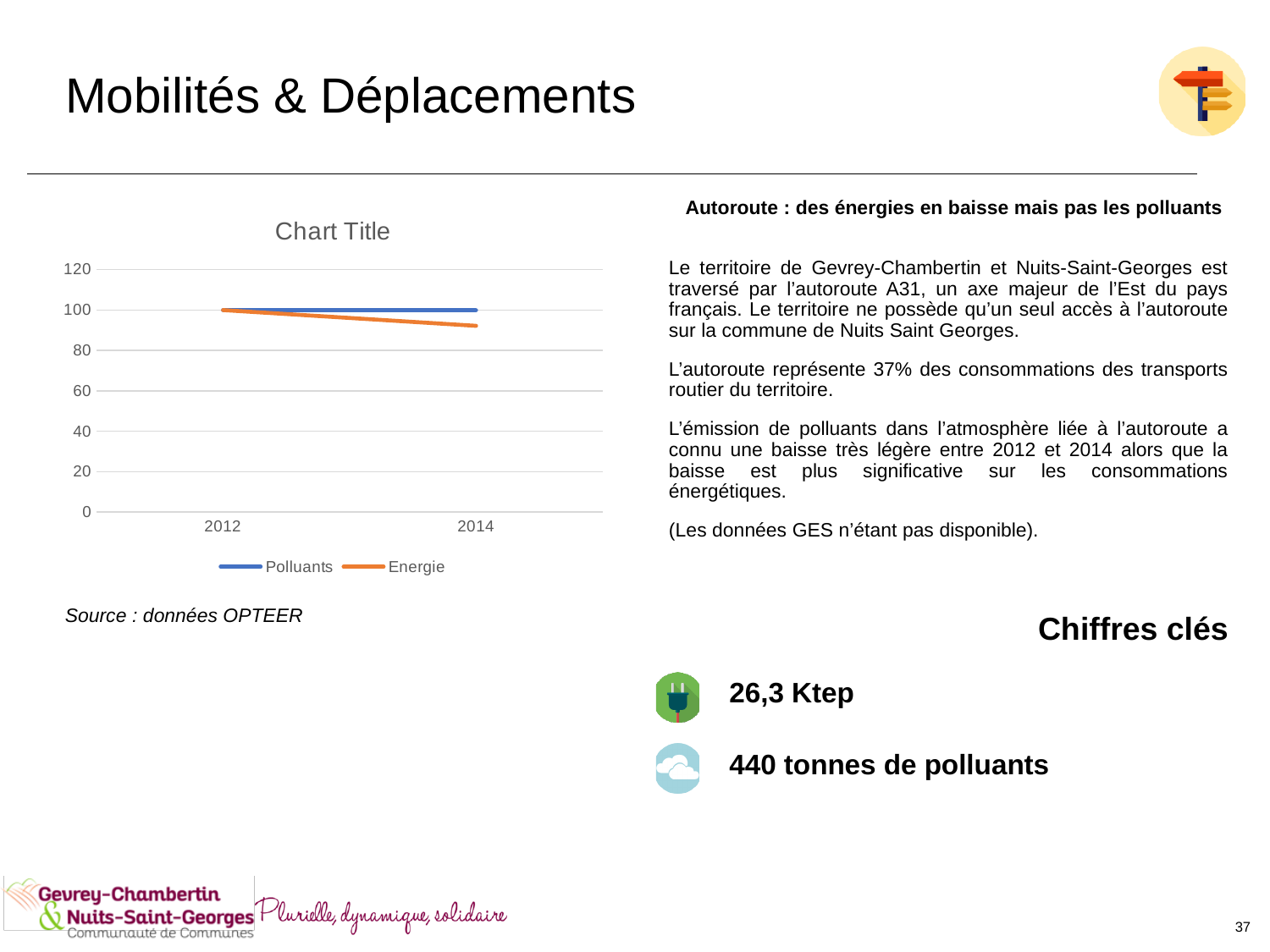
Does the Energie line rise or fall from 2012 to 2014? fall Which two years are shown on the x axis of the chart? 2012 and 2014 In 2014, which series has the higher value, Polluants or Energie? Polluants Which series has the lowest value in 2014? Energie How many years are shown on the x axis of the chart? 2 What kind of chart is shown on the slide? line chart What is the value for Polluants in 2012? 100 Which series are listed in the chart legend? Polluants and Energie What is the value for Energie in 2012? 100 Is the value for Energie in 2014 greater or less than 100? less How many series does the chart legend list? 2 Is the value for Energie in 2014 greater or less than 80? greater